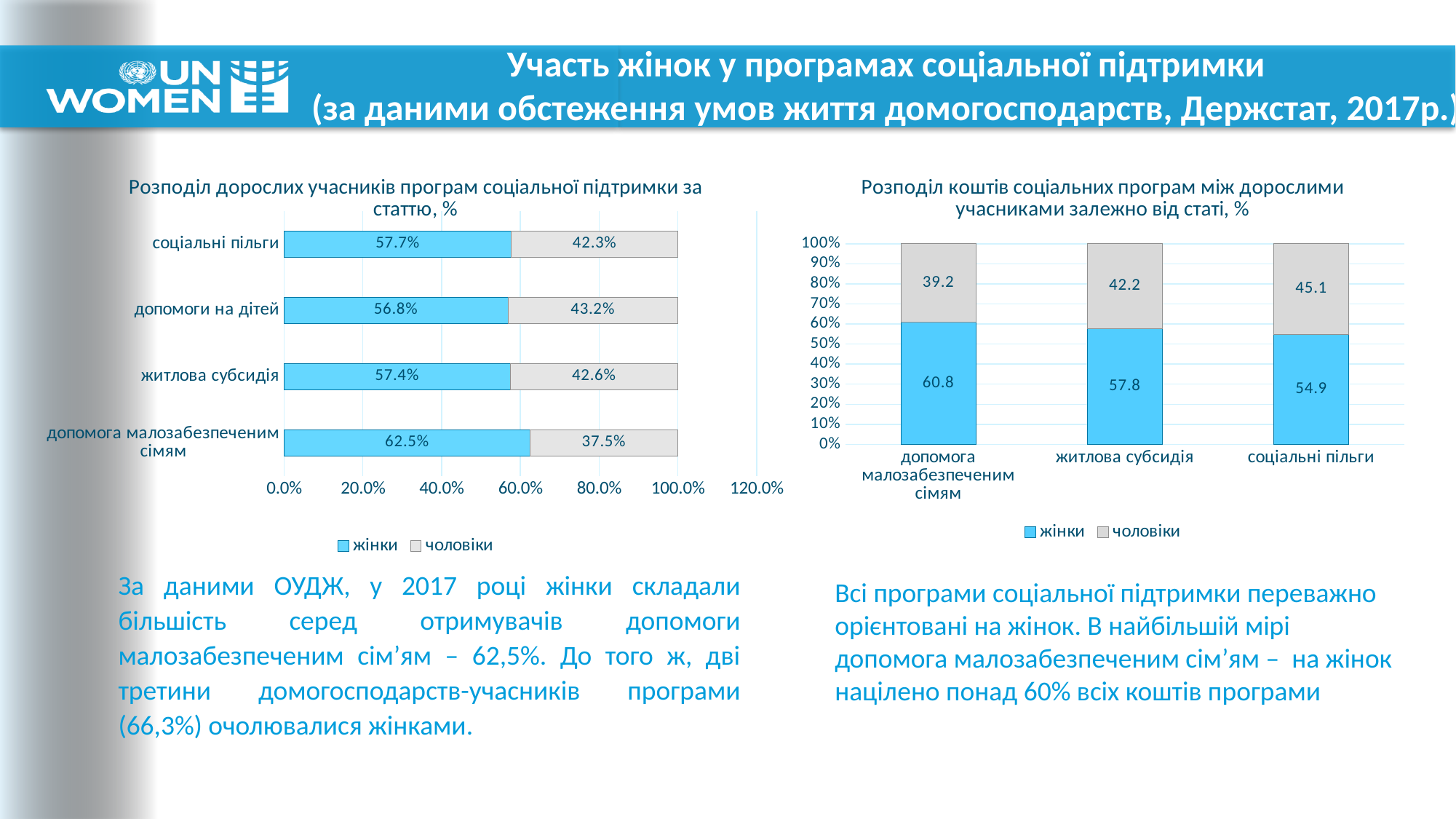
In the left chart (Розподіл дорослих учасників програм соціальної підтримки за статтю), which category has the highest value for жінки? допомога малозабезпеченим сімям In the left chart (Розподіл дорослих учасників програм соціальної підтримки за статтю), what kind of chart is it? Stacked bar chart In the left chart (Розподіл дорослих учасників програм соціальної підтримки за статтю), what is the difference between the жінки and чоловіки values for 'допомоги на дітей'? 13.6% In the left chart (Розподіл дорослих учасників програм соціальної підтримки за статтю), which category has the lowest value for чоловіки? допомога малозабезпеченим сімям In the left chart (Розподіл дорослих учасників програм соціальної підтримки за статтю), what is the value for жінки in the category 'допомога малозабезпеченим сімям'? 62.5% In the right chart (Розподіл коштів соціальних програм між дорослими учасниками залежно від статі), how many series does the legend list? 2 In the left chart (Розподіл дорослих учасників програм соціальної підтримки за статтю), what is the value for чоловіки in the category 'соціальні пільги'? 42.3% In the right chart (Розподіл коштів соціальних програм між дорослими учасниками залежно від статі), what is the value for жінки in 'житлова субсидія'? 57.8 In the left chart (Розподіл дорослих учасників програм соціальної підтримки за статтю), how many categories are shown? 4 In the right chart (Розподіл коштів соціальних програм між дорослими учасниками залежно від статі), which category has the highest value for жінки? допомога малозабезпеченим сімям In the right chart (Розподіл коштів соціальних програм між дорослими учасниками залежно від статі), what is the value for чоловіки in 'соціальні пільги'? 45.1 In the right chart (Розподіл коштів соціальних програм між дорослими учасниками залежно від статі), which is larger: the чоловіки value for 'житлова субсидія' or for 'допомога малозабезпеченим сімям'? житлова субсидія